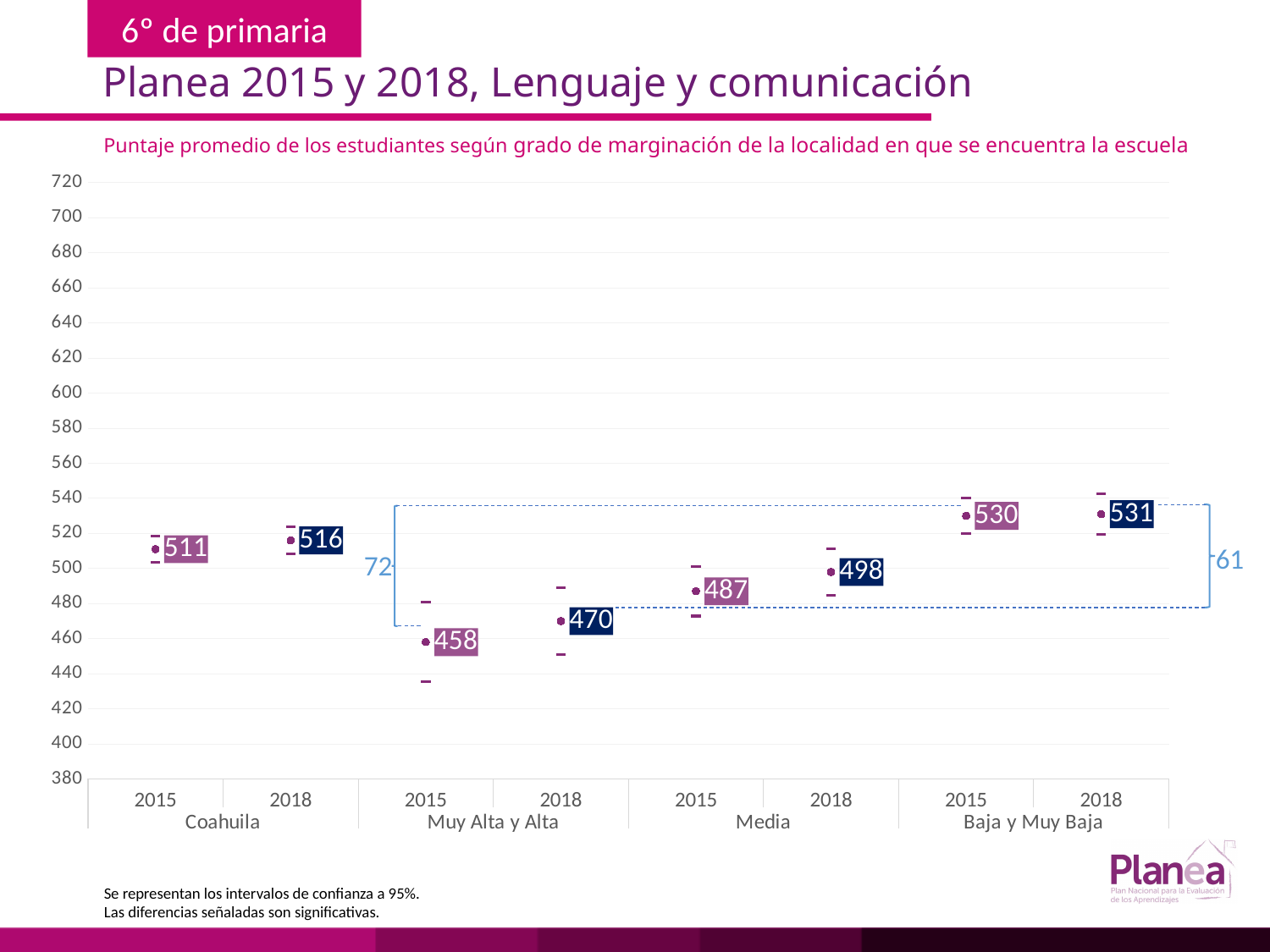
What is the average score for the Muy Alta y Alta marginalization group in 2018? 470 Which group and year has the highest average score? Baja y Muy Baja, 2018 What is the subtitle of the chart? Puntaje promedio de los estudiantes según grado de marginación de la localidad en que se encuentra la escuela What is the difference between the 2018 and 2015 scores for the Media group? 11 Which is larger, the 2018 score for Coahuila or the 2018 score for the Media group? Coahuila 2018 What is the average score for the Baja y Muy Baja group in 2018? 531 Is the 2015 score for the Muy Alta y Alta group greater or less than 460? less What is the average score for the Media group in 2015? 487 What is the difference between the Baja y Muy Baja and Muy Alta y Alta scores in 2015? 72 What is the average score for Coahuila in 2015? 511 Which group and year has the lowest average score? Muy Alta y Alta, 2015 How many data points are plotted on the chart? 8